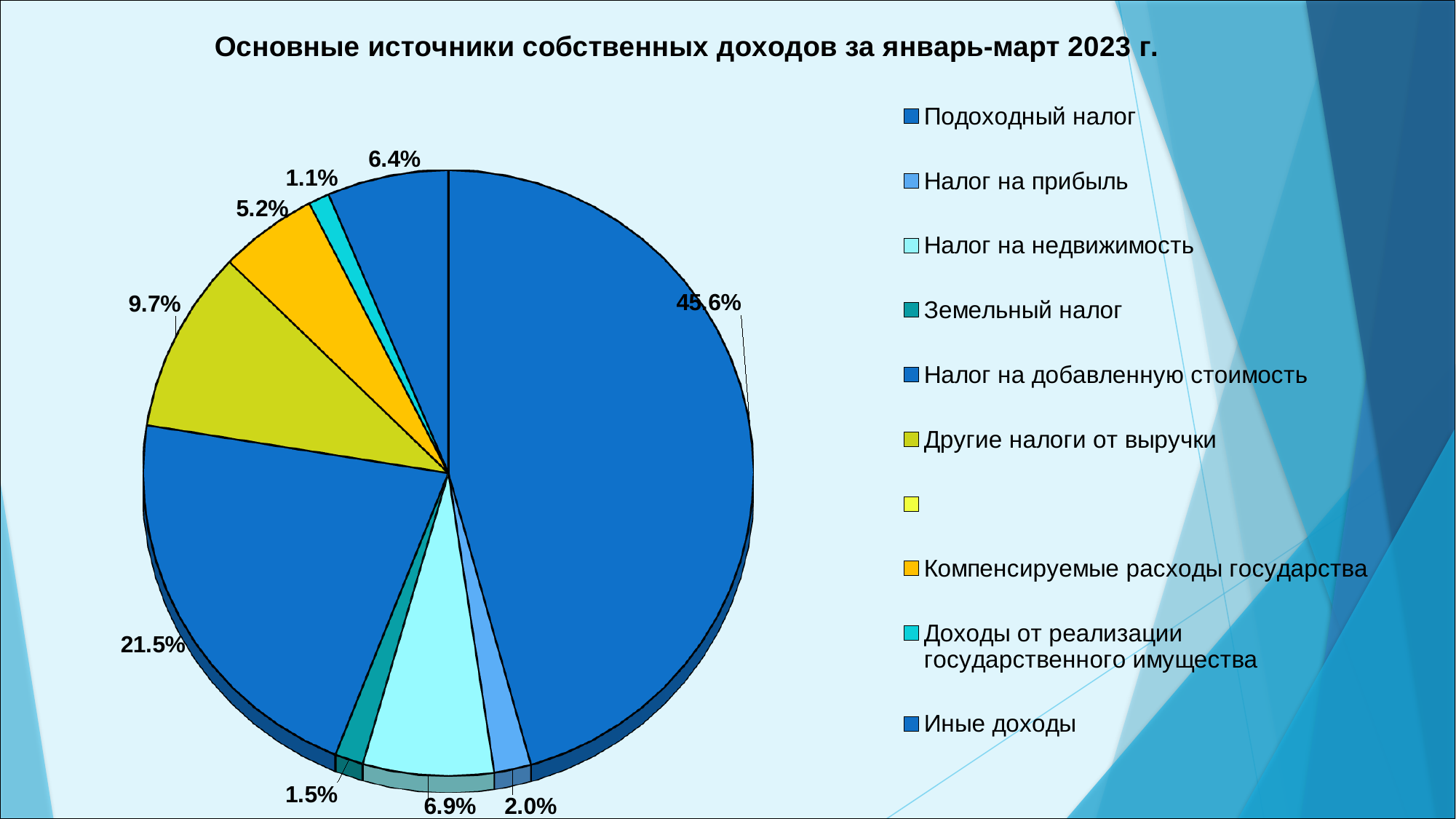
Which source has the smallest share of the pie? Доходы от реализации государственного имущества What is the difference between the shares of Подоходный налог and Налог на добавленную стоимость? 24.1% What share of the pie does Налог на недвижимость have? 6.9% What is the combined share of Земельный налог and Налог на прибыль? 3.5% What kind of chart is shown on the slide? pie chart Which source has the largest share of the pie? Подоходный налог What is the title of the chart? Основные источники собственных доходов за январь-март 2023 г. Which is larger, the share of Другие налоги от выручки or the share of Иные доходы? Другие налоги от выручки What share of the pie does Налог на добавленную стоимость have? 21.5% What share of the pie does Компенсируемые расходы государства have? 5.2% What share of the pie does Подоходный налог have? 45.6% How many labelled slices does the pie chart have? 9